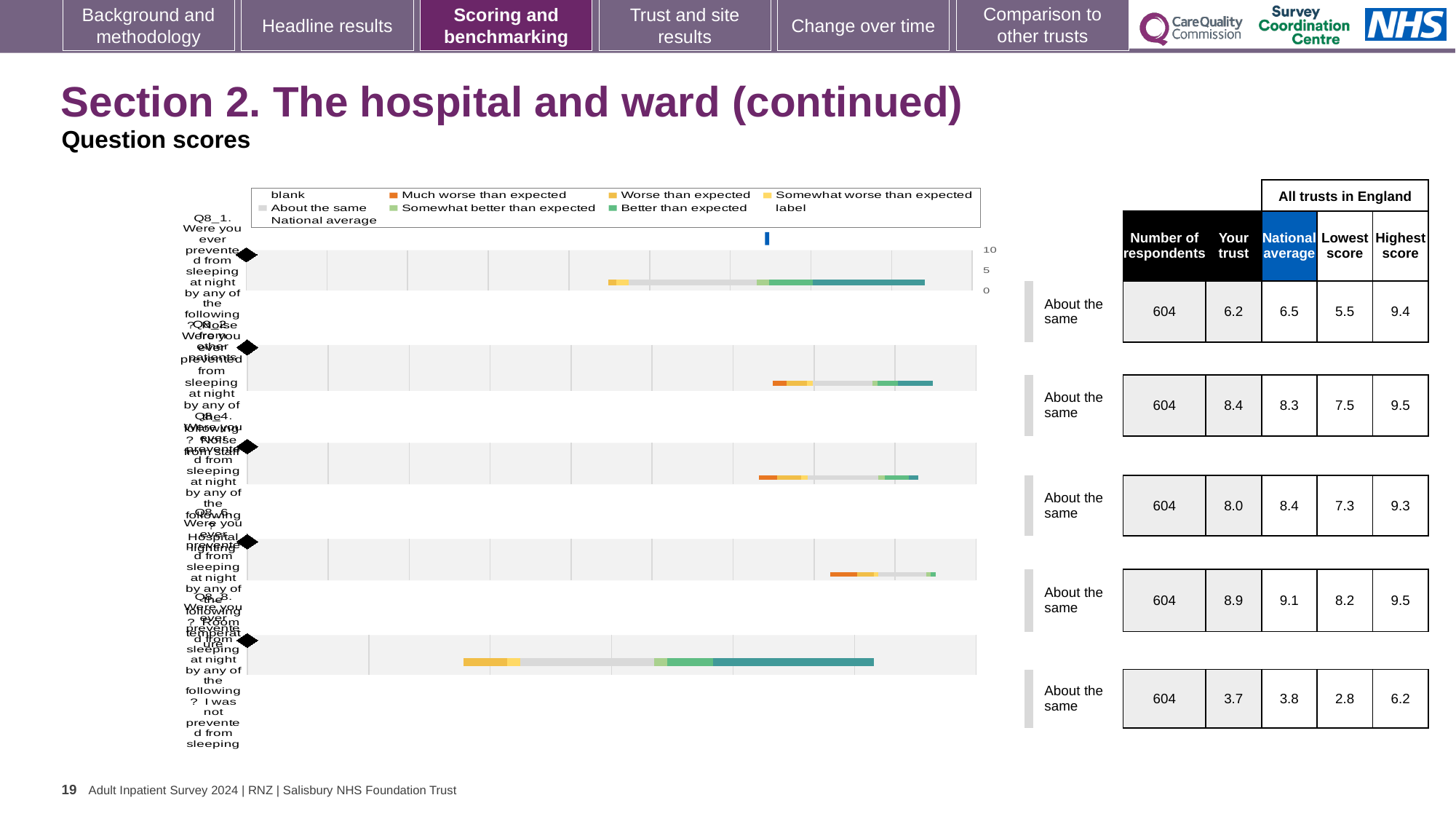
In the table beside the chart, what is the 'Your trust' score for the top row (Q8_1)? 6.2 Which row has the lowest 'Your trust' score in the table? the bottom row (Q8_8), 3.7 In the table beside the chart, what is the 'Lowest score' for the third row (Q8_4)? 7.3 Which row has the highest 'Your trust' score in the table? the fourth row (Q8_6), 8.9 In the table beside the chart, what is the 'National average' for the bottom row (Q8_8)? 3.8 How many respondents are listed for each question in the table? 604 What benchmark label is shown next to every bar in the chart? About the same What is the difference between the highest 'Your trust' score (8.9) and the lowest 'Your trust' score (3.7) in the table? 5.2 In the table beside the chart, what is the 'Highest score' for the second row (Q8_2)? 9.5 How many question rows (bars) are plotted in the chart? 5 In the chart legend, what colour represents 'Better than expected'? teal What kind of chart is used to show the question scores on this slide? bar chart